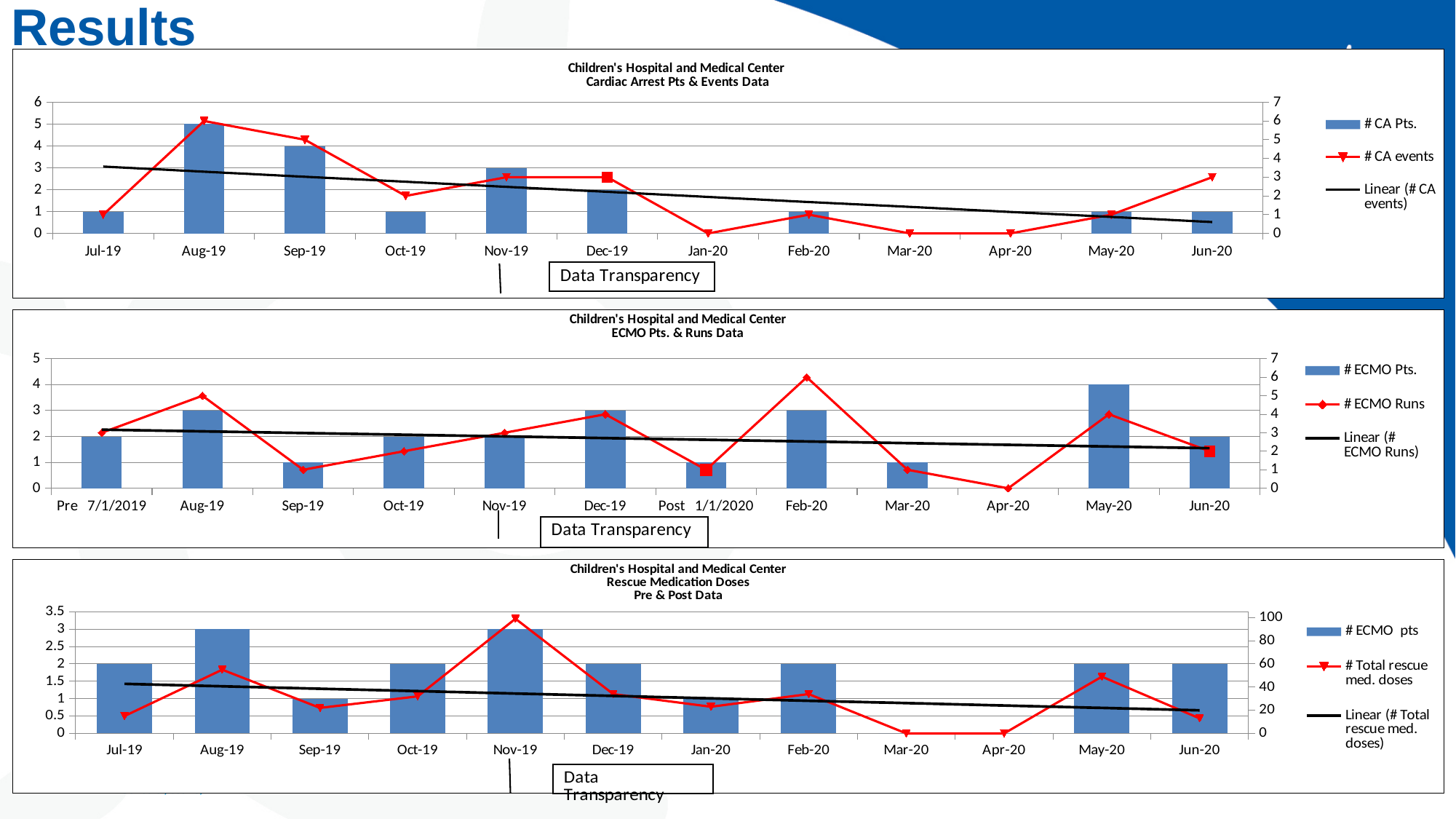
In the Rescue Medication Doses Pre & Post Data chart, does the Linear (# Total rescue med. doses) trendline rise or fall from Jul-19 to Jun-20? fall In the ECMO Pts. & Runs Data chart, how many categories are shown on the x axis? 12 In the ECMO Pts. & Runs Data chart, what is the # ECMO Runs value for Feb-20? 6 In the ECMO Pts. & Runs Data chart, which month has the highest # ECMO Pts.? May-20 In the Cardiac Arrest Pts & Events Data chart, what is the # CA Pts. value for Sep-19? 4 In the Cardiac Arrest Pts & Events Data chart, how many series does the legend list? 3 In the Cardiac Arrest Pts & Events Data chart, what is the # CA events value for Aug-19? 6 In the Rescue Medication Doses Pre & Post Data chart, what is the # ECMO pts value for Jan-20? 1 In the Cardiac Arrest Pts & Events Data chart, which month has the highest # CA Pts.? Aug-19 In the Rescue Medication Doses Pre & Post Data chart, is the # Total rescue med. doses value for Nov-19 greater or less than 80? greater In the Cardiac Arrest Pts & Events Data chart, what kind of chart is used to show the # CA Pts. series? bar chart In the Cardiac Arrest Pts & Events Data chart, what is the difference in # CA Pts. between Aug-19 and Sep-19? 1